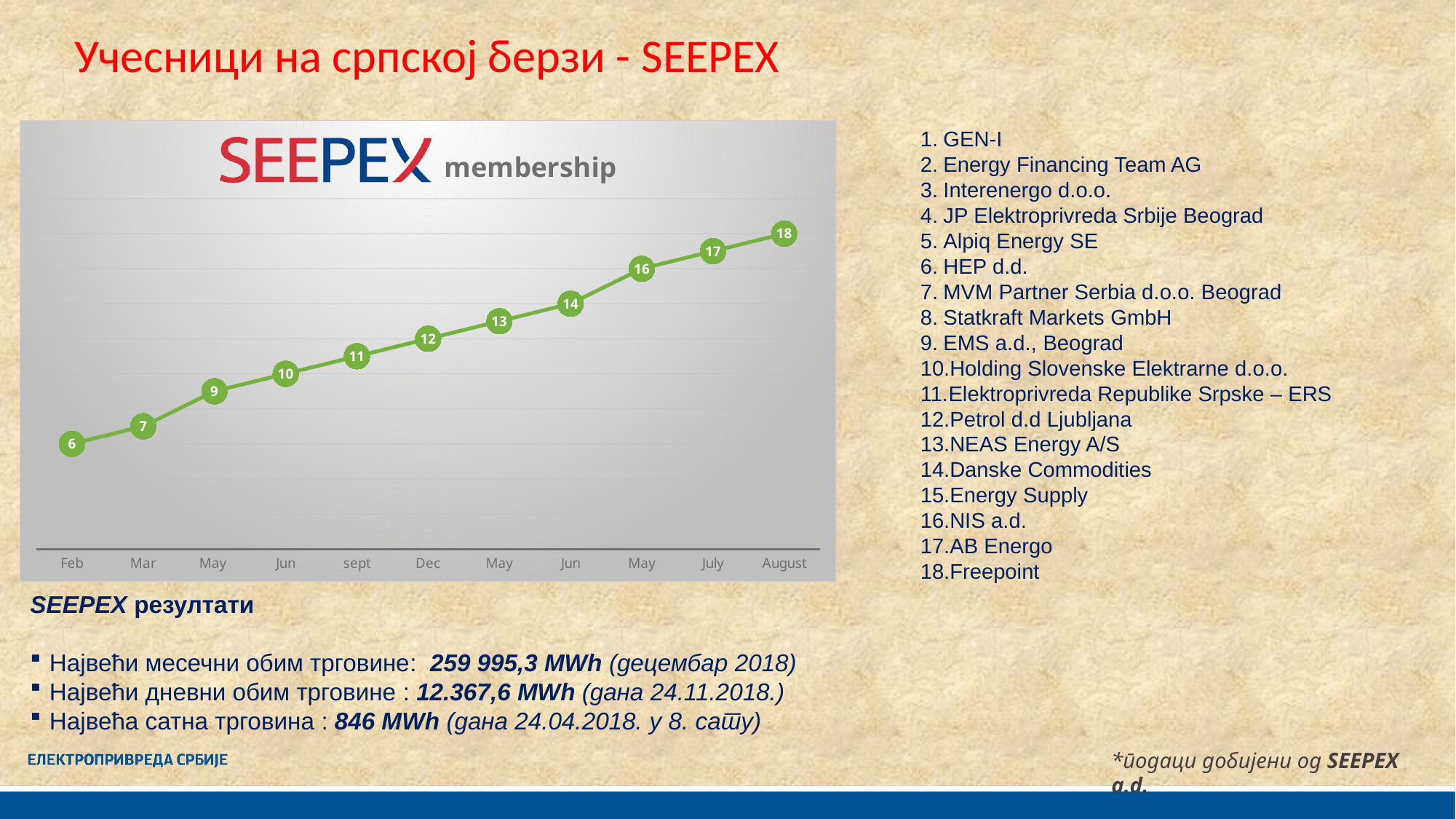
Which x-axis label has the lowest membership value? Feb Which x-axis label has the highest membership value? August What kind of chart is shown on the slide? line chart What is the membership value at July? 17 What is the membership value at Dec? 12 Do the membership values rise or fall along the x axis? rise By how much did membership increase from Feb (first point) to August (last point)? 12 What is the membership value at Mar? 7 What is the membership value at sept? 11 How many data points are plotted on the SEEPEX membership line? 11 What is the membership value at August, the last point on the chart? 18 What is the membership value at Feb, the first point on the chart? 6